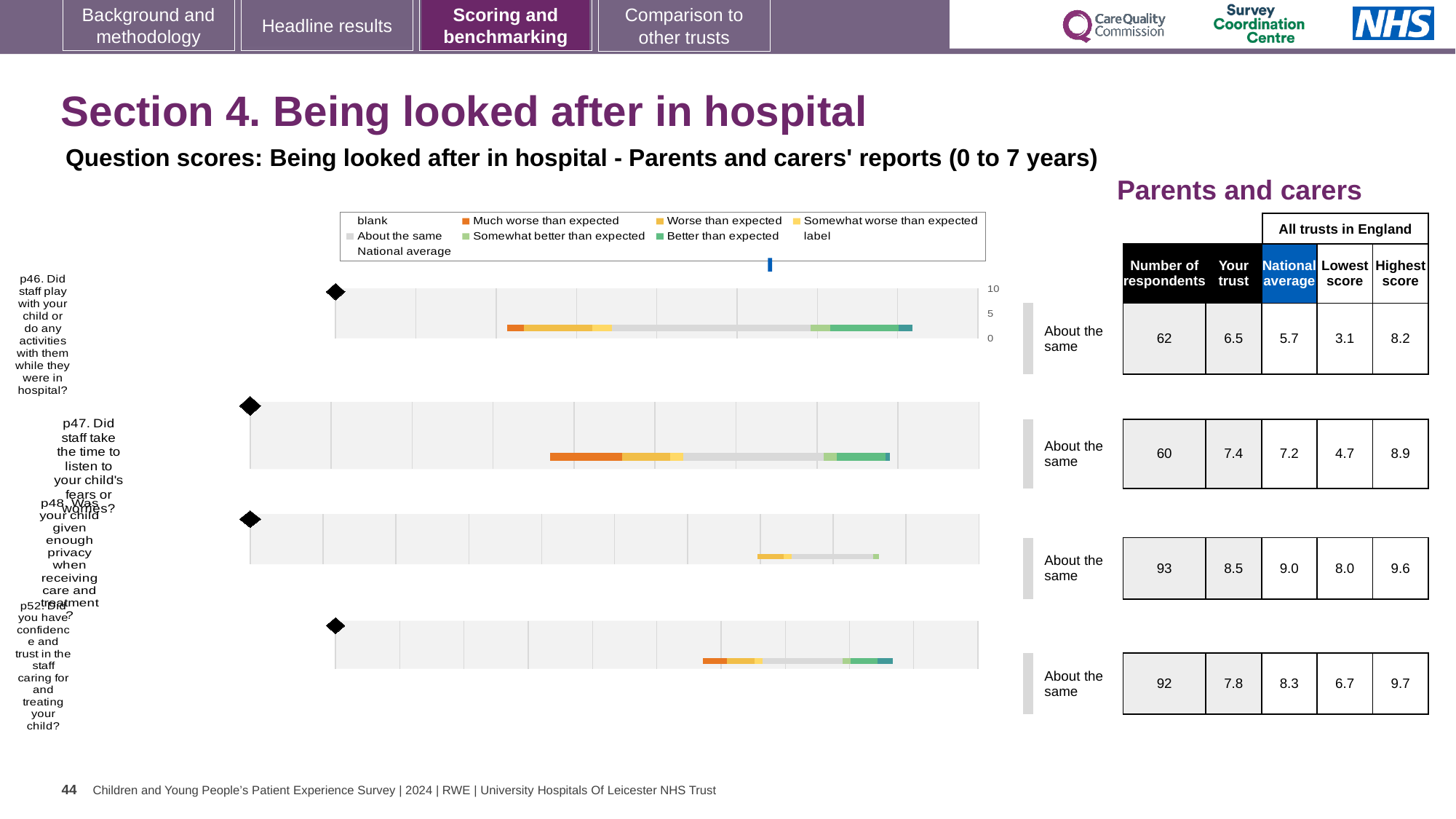
How many questions (p46, p47, p48, p52) have a bar chart on this slide? 4 Which question has the lowest 'Lowest score' across all trusts in England? p46 For p48 (Was your child given enough privacy when receiving care and treatment?), which is larger: the 'Your trust' score or the National average? National average In the table beside the chart for p46 (Did staff play with your child or do any activities with them while they were in hospital?), what is the 'Your trust' score? 6.5 What is the subtitle above the charts describing the question scores? Question scores: Being looked after in hospital - Parents and carers' reports (0 to 7 years) Which question has the highest number of respondents? p48 What benchmark category is shown next to the chart for p46? About the same What is the number of respondents for p52 (Did you have confidence and trust in the staff caring for and treating your child?)? 92 In the table beside the chart for p47 (Did staff take the time to listen to your child's fears or worries?), what is the National average score? 7.2 For p52 (Did you have confidence and trust in the staff caring for and treating your child?), what is the difference between the Highest score and the Lowest score across all trusts in England? 3.0 What kind of chart is used to show the question scores on this slide? bar chart What colour does the legend use for 'Much worse than expected'? orange